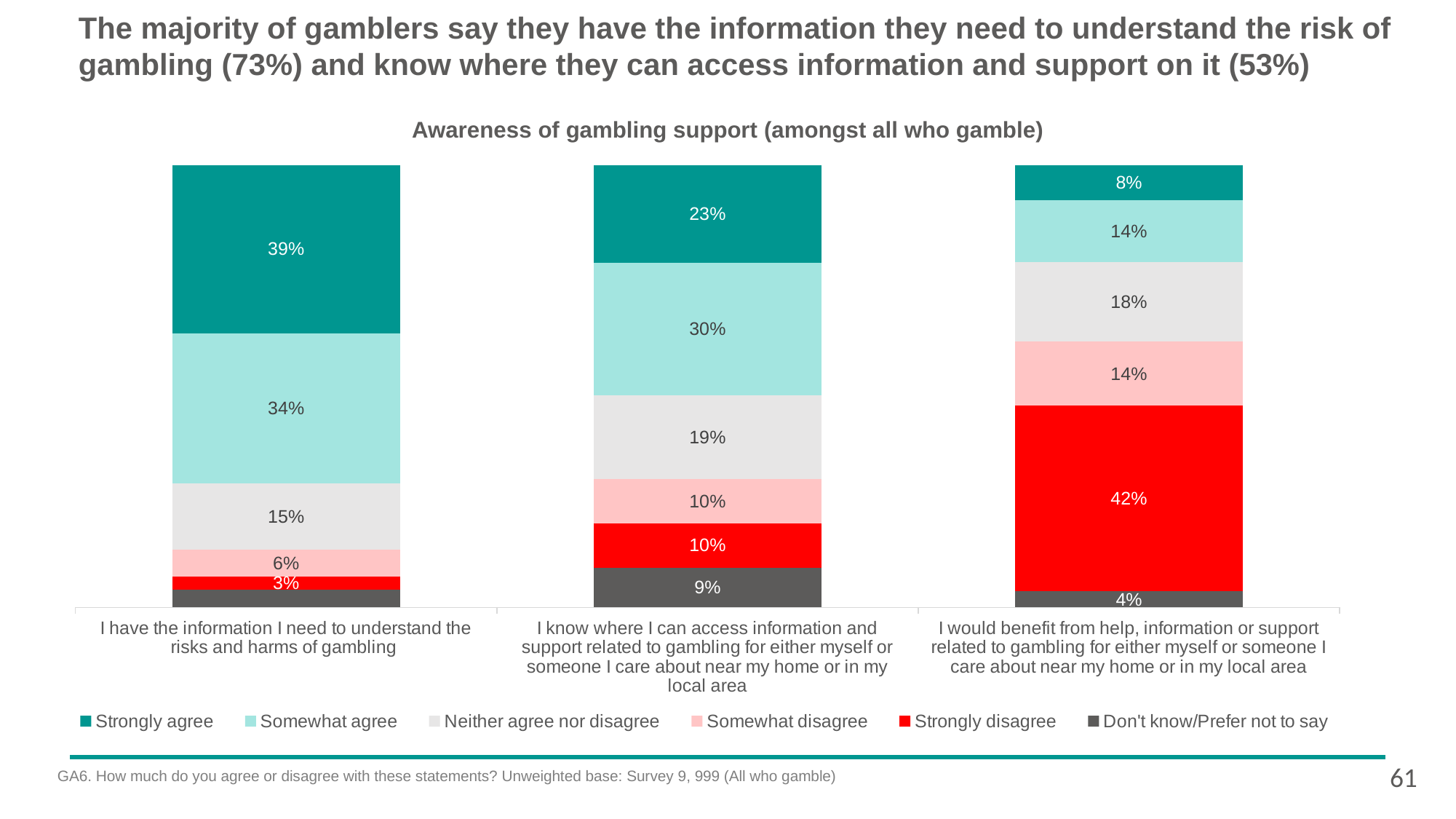
What percentage strongly agree with 'I have the information I need to understand the risks and harms of gambling'? 39% What percentage somewhat agree with 'I know where I can access information and support related to gambling for either myself or someone I care about near my home or in my local area'? 30% What kind of chart is shown on the slide? Stacked bar chart How many statements (categories) are plotted on the chart? 3 Which is larger: the 'Neither agree nor disagree' share for 'I know where I can access information and support...' or for 'I would benefit from help, information or support...'? I know where I can access information and support... Which statement has the highest 'Strongly agree' percentage? I have the information I need to understand the risks and harms of gambling What is the difference between the 'Strongly agree' percentages for 'I have the information I need to understand the risks and harms of gambling' and 'I know where I can access information and support related to gambling...'? 16% What is the title of the chart? Awareness of gambling support (amongst all who gamble) What is the 'Don't know/Prefer not to say' percentage for 'I know where I can access information and support related to gambling for either myself or someone I care about near my home or in my local area'? 9% What percentage strongly disagree with 'I would benefit from help, information or support related to gambling for either myself or someone I care about near my home or in my local area'? 42% How many series does the legend list? 6 Which statement has the lowest 'Strongly disagree' percentage? I have the information I need to understand the risks and harms of gambling